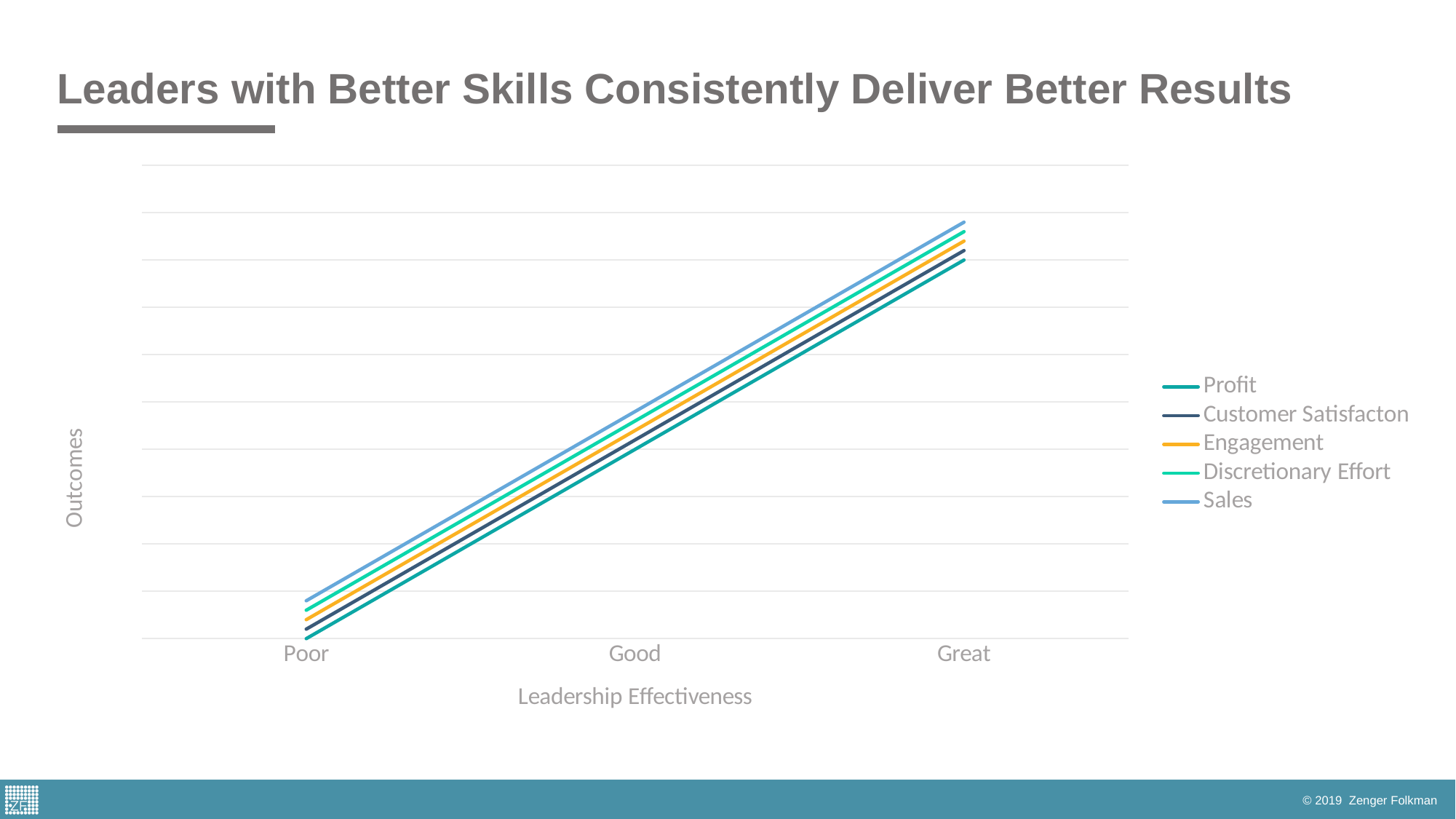
What is the title of the chart's x axis? Leadership Effectiveness Which series has the highest value at Great? Sales How many series does the legend list? 5 Which is larger at Great, the value for Sales or the value for Profit? Sales Do the values rise or fall as leadership effectiveness moves from Poor to Great? Rise How many categories are shown on the x axis? 3 Which series has the lowest value at Poor? Profit What is the title of the slide? Leaders with Better Skills Consistently Deliver Better Results What kind of chart is shown on the slide? Line chart Which series has the lowest value at Great? Profit